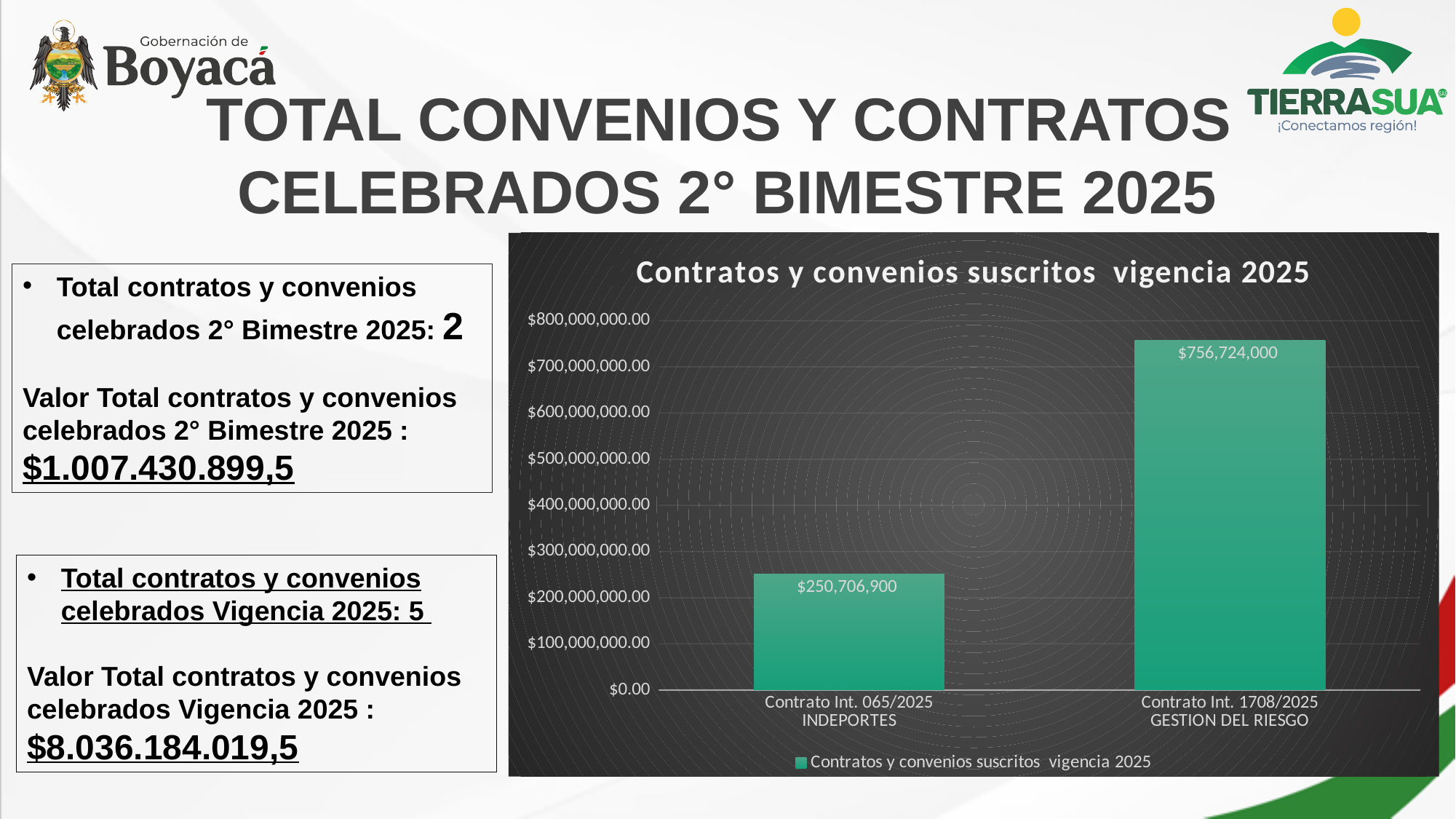
What is the difference between the values for Contrato Int. 1708/2025 GESTION DEL RIESGO and Contrato Int. 065/2025 INDEPORTES? $506,017,100 How many categories are shown in the chart? 2 What is the title of the chart? Contratos y convenios suscritos vigencia 2025 Is the value for Contrato Int. 1708/2025 GESTION DEL RIESGO greater or less than $700,000,000.00? greater Which category has the lowest value? Contrato Int. 065/2025 INDEPORTES What is the value for Contrato Int. 065/2025 INDEPORTES? $250,706,900 Is the value for Contrato Int. 065/2025 INDEPORTES greater or less than $300,000,000.00? less How many series does the legend list? 1 Which category has the highest value? Contrato Int. 1708/2025 GESTION DEL RIESGO Which is larger, the value for Contrato Int. 065/2025 INDEPORTES or the value for Contrato Int. 1708/2025 GESTION DEL RIESGO? Contrato Int. 1708/2025 GESTION DEL RIESGO What is the value for Contrato Int. 1708/2025 GESTION DEL RIESGO? $756,724,000 What kind of chart is shown on the slide? bar chart